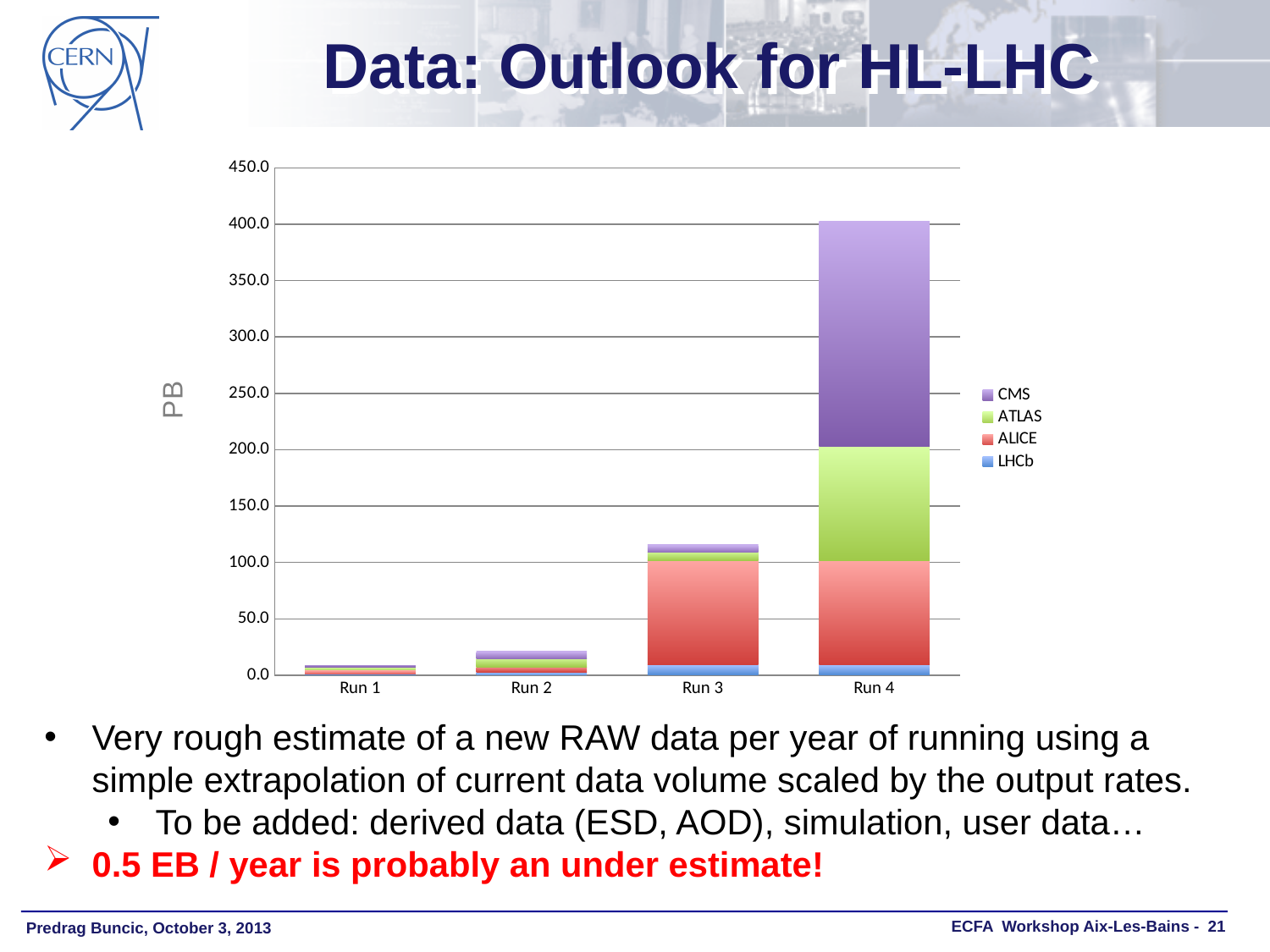
Do the stacked bar totals rise or fall from Run 1 to Run 4? rise How many runs (categories) are shown on the x axis of the chart? 4 Is the total for Run 4 greater or less than 350? greater Is the total for Run 3 greater or less than 100? greater Which has the larger total, Run 3 or Run 4? Run 4 How many series does the chart legend list? 4 Is the total for Run 2 greater or less than 50? less What is the label on the y axis of the chart? PB Which run has the tallest stacked bar in the chart? Run 4 Which run has the shortest stacked bar in the chart? Run 1 What kind of chart is shown on the slide? stacked bar chart Which series is shown in purple in the chart legend? CMS